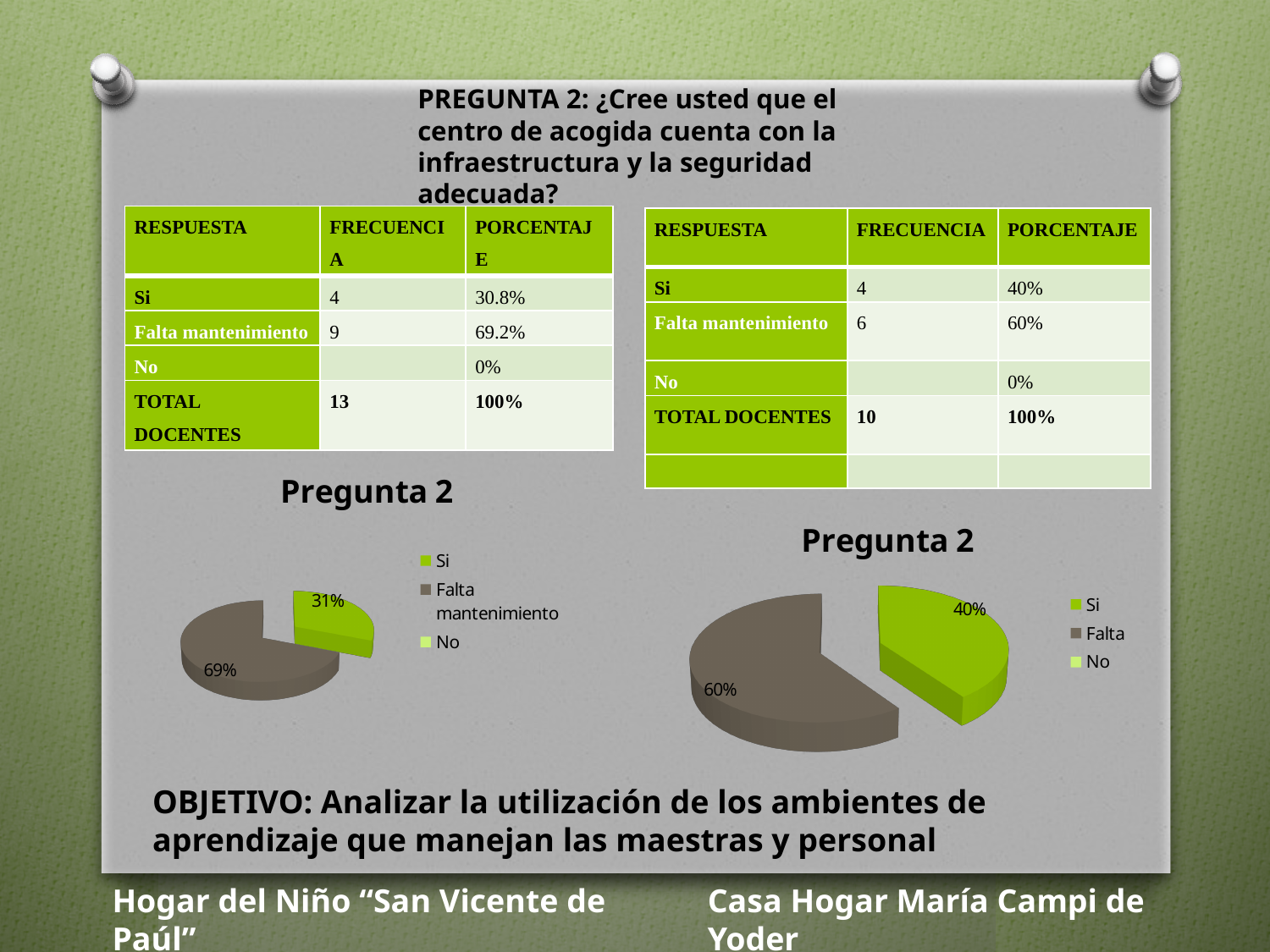
In the left pie chart, what is the difference between the Falta mantenimiento and Si percentages? 38% How many entries does the legend of the right pie chart list? 3 In the right pie chart, what is the difference between the Falta mantenimiento and Si percentages? 20% What type of chart is the left chart titled Pregunta 2? Pie chart In the right pie chart, which category has the smallest visible slice? Si In the left pie chart, which category has the largest slice? Falta mantenimiento In the left pie chart titled Pregunta 2, what percentage is shown for Falta mantenimiento? 69% In the right pie chart titled Pregunta 2, what percentage is shown for Falta mantenimiento? 60% In the right pie chart titled Pregunta 2, what percentage is shown for Si? 40% In the right pie chart, which is larger, the Si slice or the Falta mantenimiento slice? Falta mantenimiento What is the title of the right pie chart? Pregunta 2 In the left pie chart titled Pregunta 2, what percentage is shown for Si? 31%